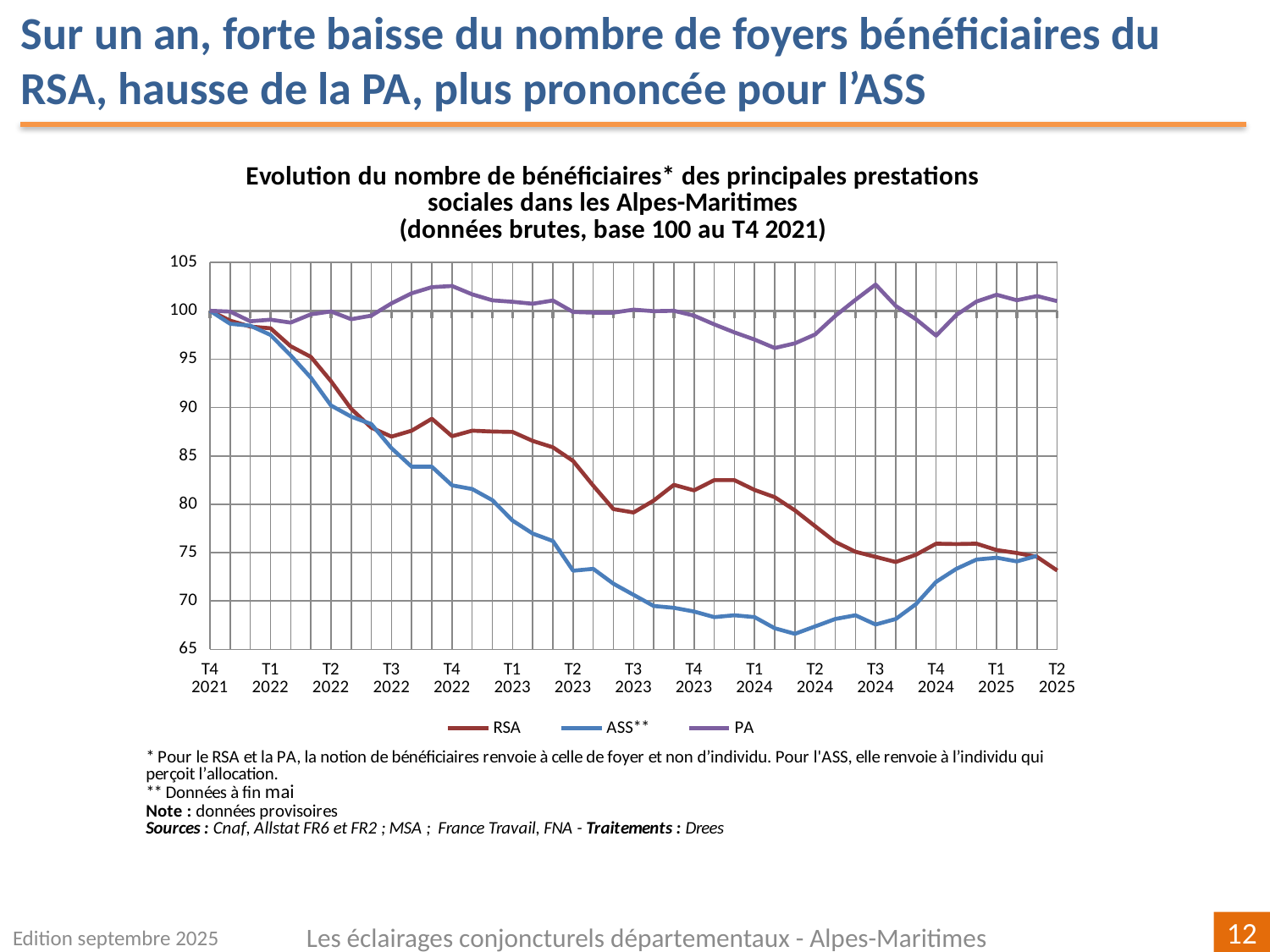
Is the value for ASS** at T2 2024 greater or less than 70? less How many series does the legend list? 3 Is the value for PA at T4 2024 greater or less than 100? less Is the value for PA at T3 2024 greater or less than 100? greater What kind of chart is shown on the slide? line chart Which series has the lowest value at T2 2024? ASS** What is the base period (base 100) stated in the chart title? T4 2021 Which series has the highest value at T2 2025? PA At T4 2023, which is larger, the value for RSA or the value for ASS**? RSA Which series are listed in the legend? RSA, ASS**, PA